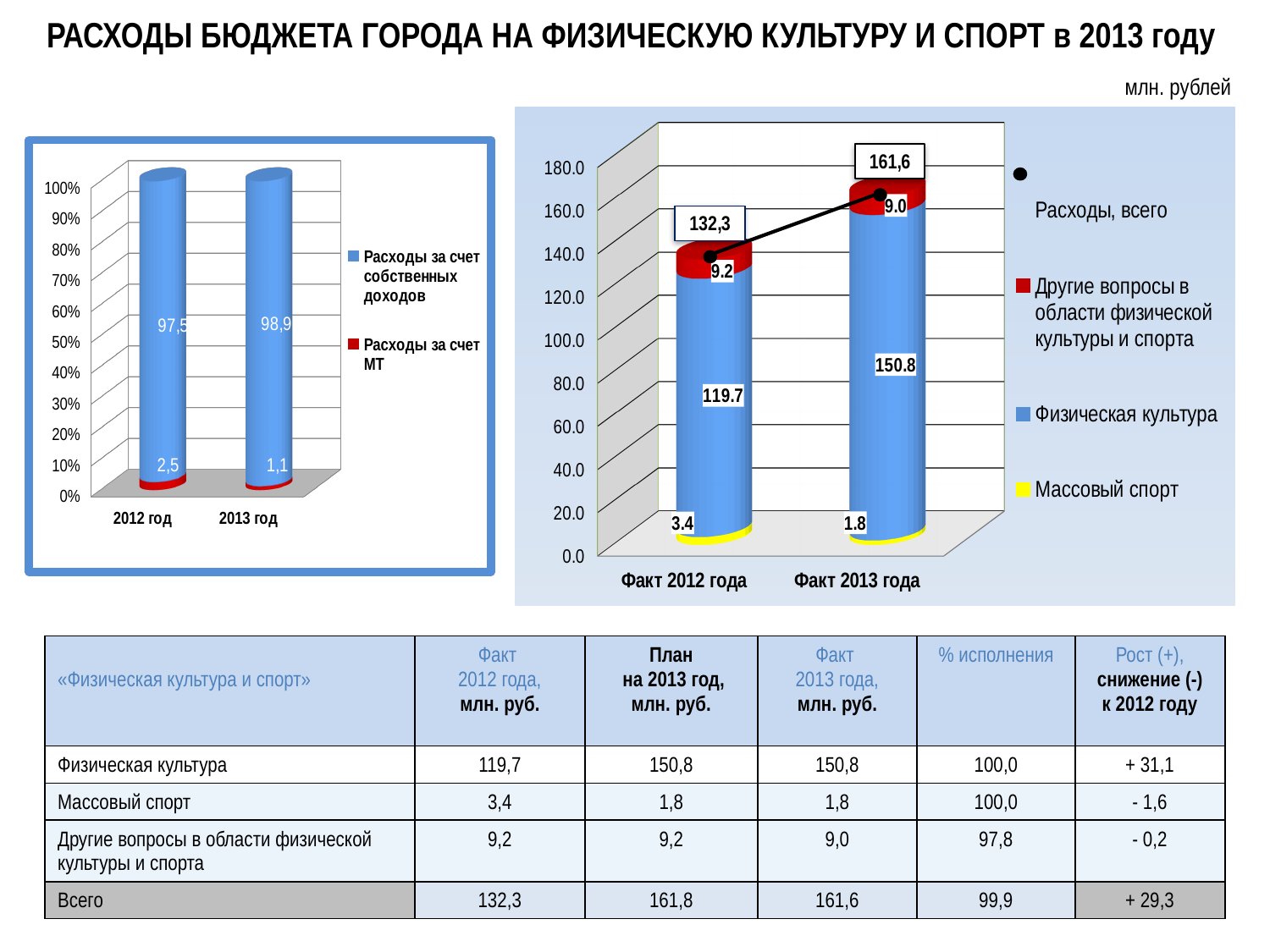
In the right chart, what is the value of Массовый спорт for Факт 2012 года? 3.4 In the left chart, what is the value of Расходы за счет МТ for 2013 год? 1,1 In the left chart, how many categories are shown on the x axis? 2 In the right chart, what is the value of Расходы, всего for Факт 2013 года? 161,6 In the right chart, by how much did Физическая культура increase from Факт 2012 года to Факт 2013 года? 31.1 What kind of chart is the left chart? bar chart In the right chart, what is the value of Физическая культура for Факт 2013 года? 150.8 In the right chart, which is larger: Массовый спорт for Факт 2012 года or for Факт 2013 года? Факт 2012 года In the left chart, what is the value of Расходы за счет собственных доходов for 2012 год? 97,5 In the right chart, does Расходы, всего rise or fall from Факт 2012 года to Факт 2013 года? rise In the right chart, what is the value of Другие вопросы в области физической культуры и спорта for Факт 2012 года? 9.2 In the right chart, how many series does the legend list? 4